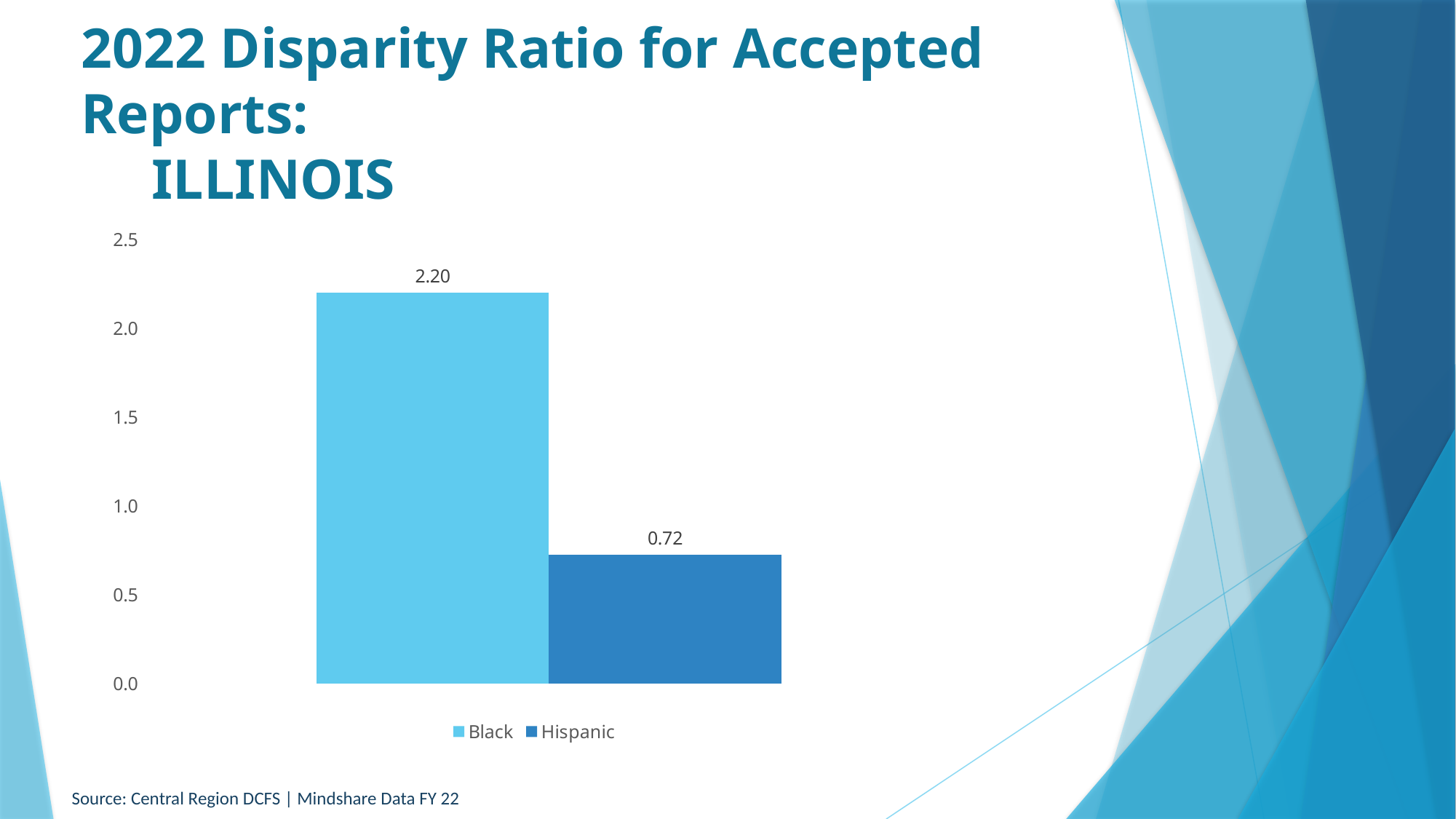
How many series does the legend list? 2 What is the disparity ratio for Hispanic in the chart? 0.72 What is the disparity ratio for Black in the chart? 2.20 What is the highest value shown on the vertical axis? 2.5 Which group has the higher disparity ratio? Black What is the difference between the Black and Hispanic disparity ratios? 1.48 Is the disparity ratio for Black larger or smaller than the ratio for Hispanic? larger Is the value for Hispanic greater or less than 1.0? less Which group has the lower disparity ratio? Hispanic What kind of chart is shown on the slide? bar chart How many bars are plotted in the chart? 2 Is the value for Black greater or less than 2.0? greater